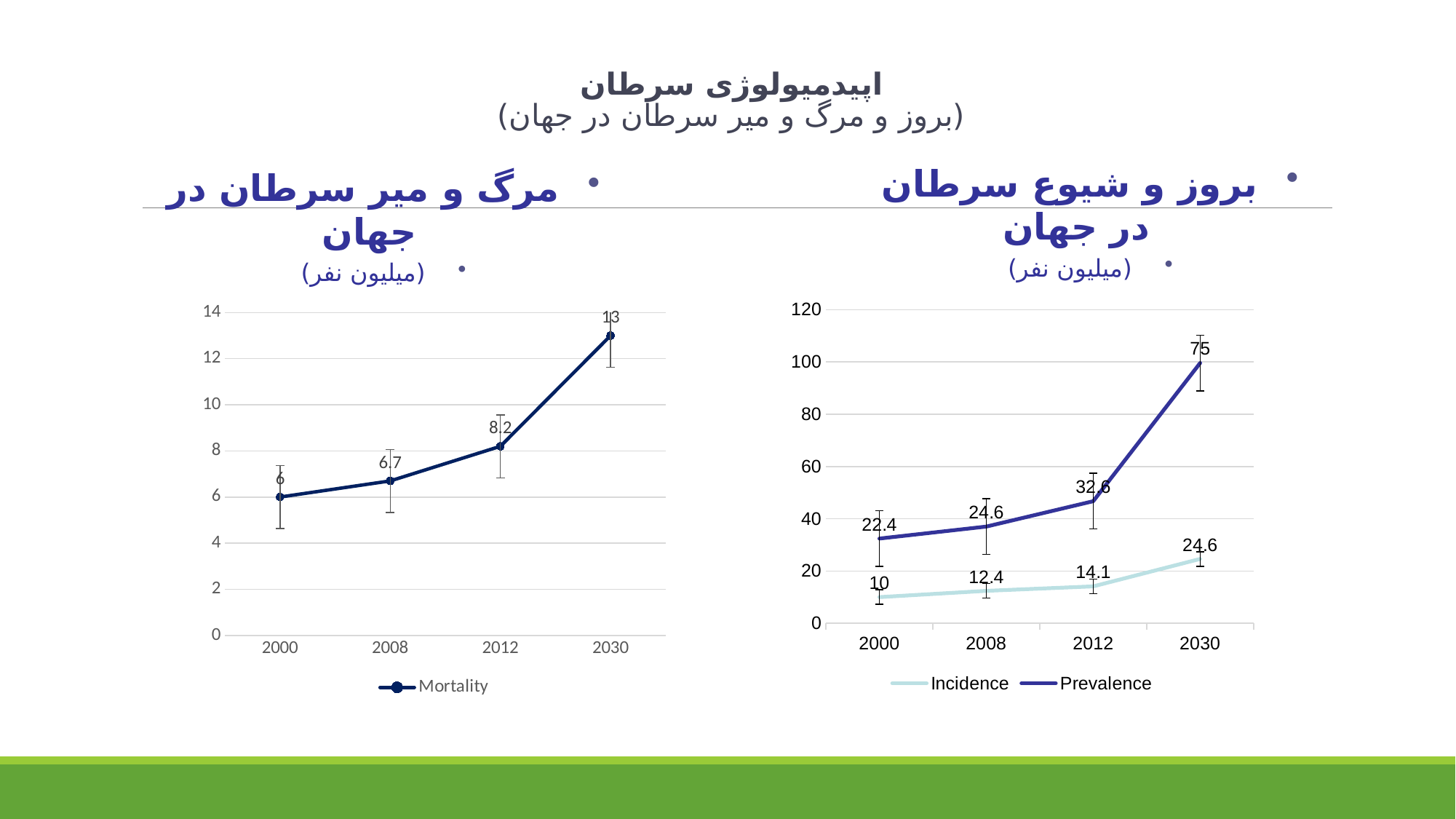
On the left chart (Mortality), what is the value for 2012? 8.2 On the left chart (Mortality), what is the value for 2030? 13 On the left chart (Mortality), what is the difference between the 2030 and 2008 values? 6.3 On the left chart (Mortality), which year has the lowest value? 2000 On the right chart, what is the Incidence value for 2008? 12.4 On the left chart (Mortality), how many years are plotted on the x axis? 4 On the right chart, how many series does the legend list? 2 On the left chart (Mortality), do the values rise or fall from 2000 to 2030? rise What kind of chart is the right chart? line chart On the right chart, what is the Incidence value for 2030? 24.6 On the right chart, which series is higher in 2012, Incidence or Prevalence? Prevalence